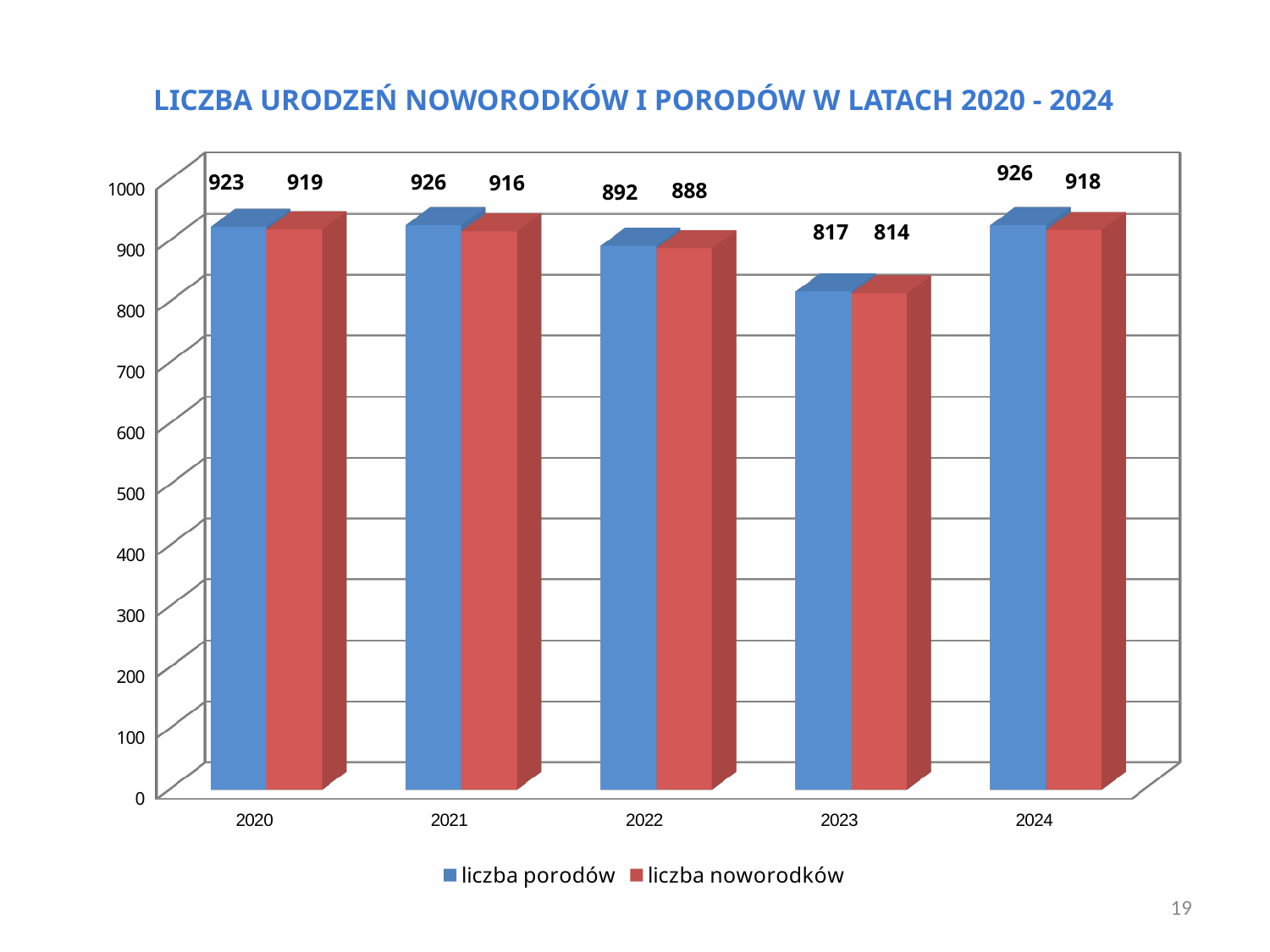
What is the difference between liczba porodów in 2024 and liczba porodów in 2023? 109 Which year has the highest value of liczba noworodków? 2020 How many years are shown on the x axis? 5 What is the value of liczba porodów for 2020? 923 How many series does the legend list? 2 What kind of chart is shown on the slide? bar chart Which is larger: liczba noworodków in 2021 or liczba noworodków in 2024? 2024 What is the difference between liczba porodów and liczba noworodków in 2021? 10 What is the value of liczba noworodków for 2022? 888 Is the value of liczba porodów for 2023 greater or less than 900? less What is the value of liczba noworodków for 2023? 814 Which year has the lowest value of liczba porodów? 2023